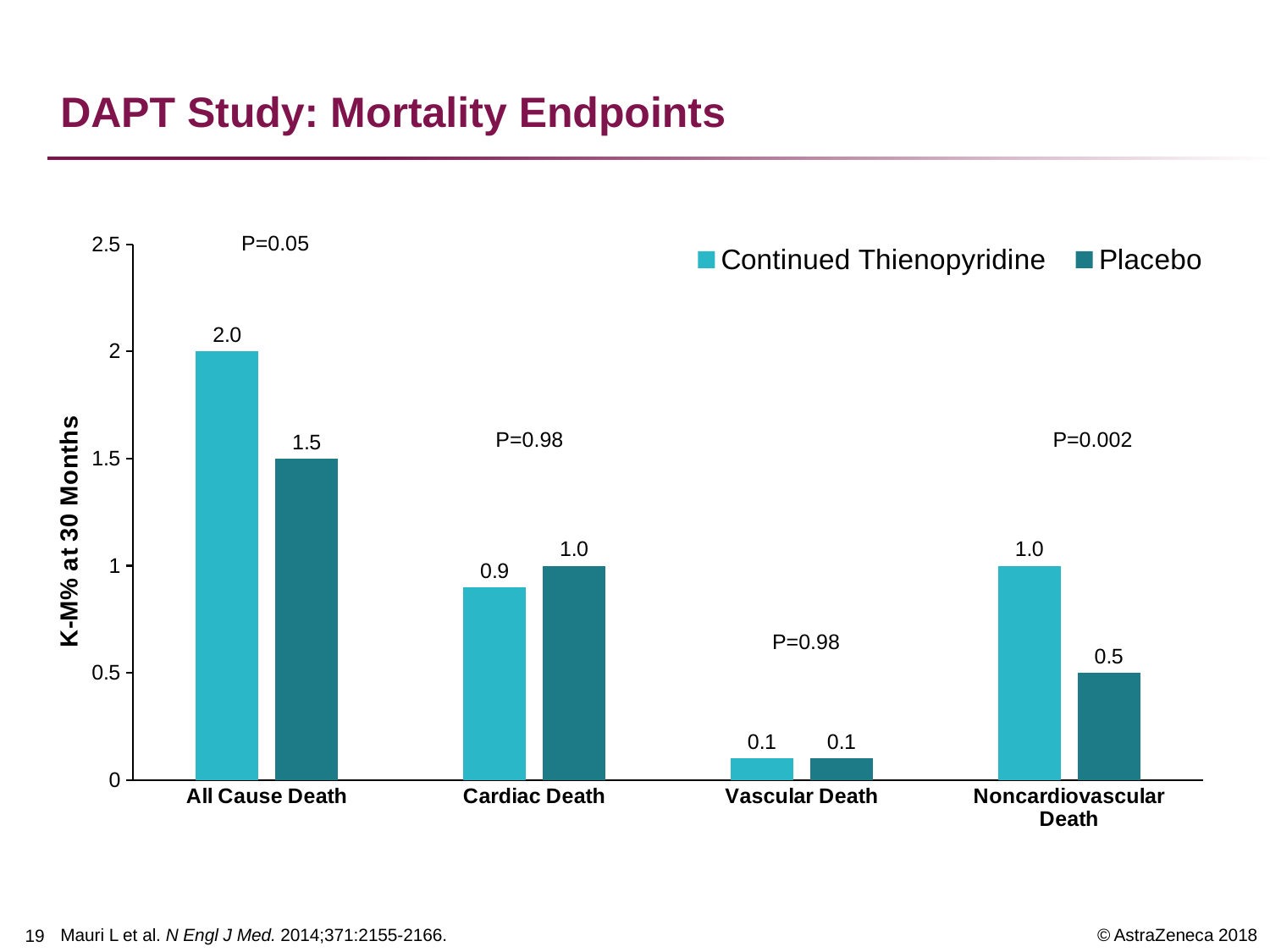
How many series does the legend list? 2 What kind of chart is shown on the slide? Bar chart How many categories are shown on the x axis? 4 What is the difference between the Continued Thienopyridine and Placebo values for Noncardiovascular Death? 0.5 For Cardiac Death, which series has the larger value, Continued Thienopyridine or Placebo? Placebo What is the value for Placebo in the Noncardiovascular Death category? 0.5 What is the difference between the Continued Thienopyridine and Placebo values for All Cause Death? 0.5 Which category has the lowest value for Placebo? Vascular Death What is the value for Continued Thienopyridine in the All Cause Death category? 2.0 What is the value for Placebo in the Cardiac Death category? 1.0 What is the label of the y axis? K-M% at 30 Months Which category has the highest value for Continued Thienopyridine? All Cause Death